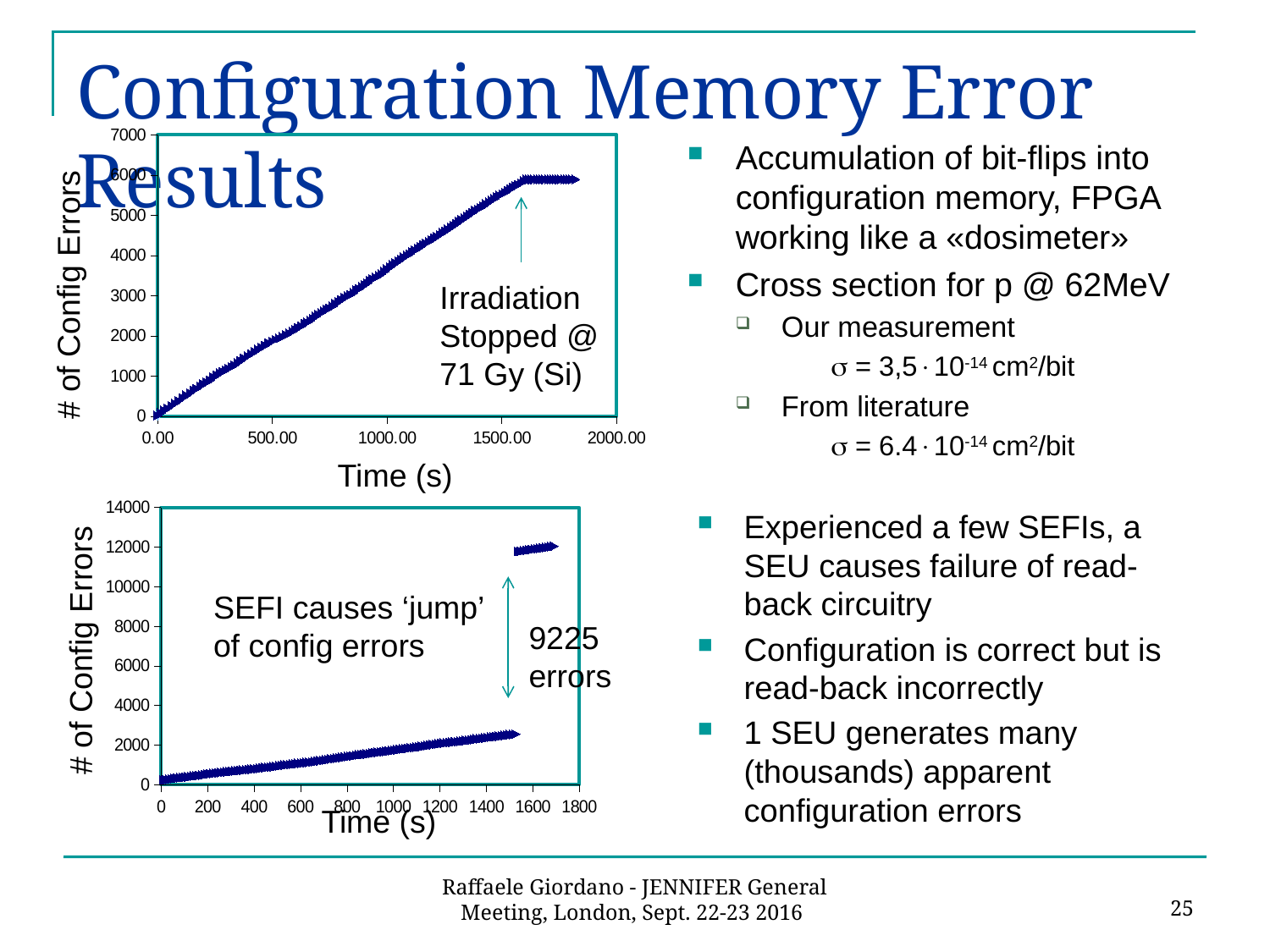
What is the x-axis title of the bottom chart? Time (s) According to the annotation on the top chart, at what dose was irradiation stopped? 71 Gy (Si) In the bottom chart, is the number of config errors after the jump (around 1600 s) greater or less than 10000? greater In the top chart, is the number of config errors at time 500 s greater or less than 1000? greater In the bottom chart, how many errors does the annotated SEFI 'jump' correspond to? 9225 errors In the top chart, is the number of config errors at time 1000 s greater or less than 3000? greater What kind of chart is the top chart on the slide? scatter chart In the bottom chart, do the number of config errors rise or fall along the time axis before the jump? rise In the top chart, do the number of config errors rise or fall as time increases from 0 to about 1500 s? rise